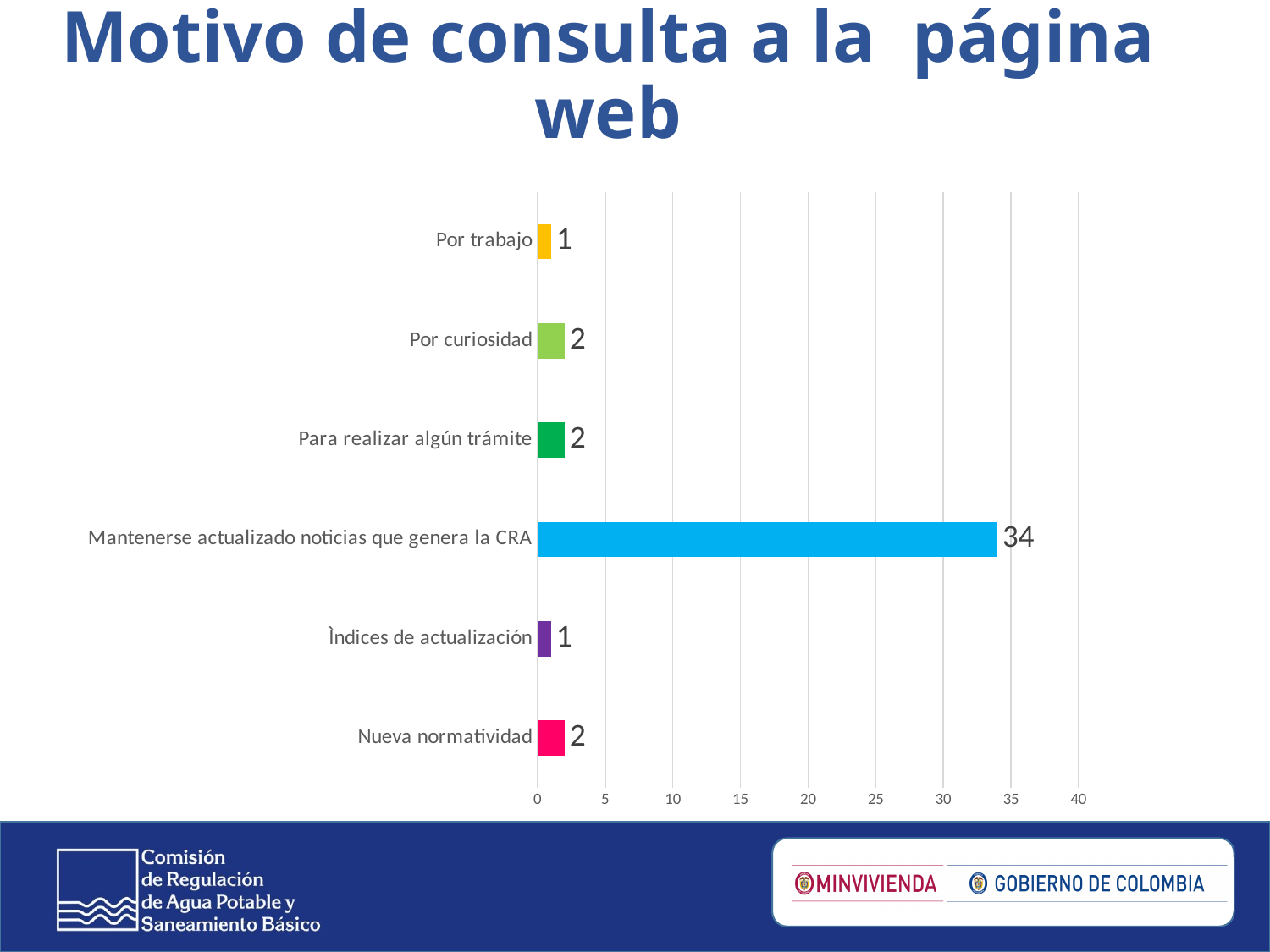
What is the difference between the values for "Mantenerse actualizado noticias que genera la CRA" and "Para realizar algún trámite"? 32 What is the title of the slide? Motivo de consulta a la página web What kind of chart is shown on the slide? bar chart What is the highest value shown on the x axis? 40 How many categories are shown in the chart? 6 Which category has the highest value? Mantenerse actualizado noticias que genera la CRA What is the value for "Mantenerse actualizado noticias que genera la CRA"? 34 Which is larger, the value for "Por curiosidad" or the value for "Ìndices de actualización"? Por curiosidad Is the value for "Mantenerse actualizado noticias que genera la CRA" greater or less than 30? greater What is the value for "Por trabajo"? 1 What is the value for "Por curiosidad"? 2 What is the value for "Nueva normatividad"? 2